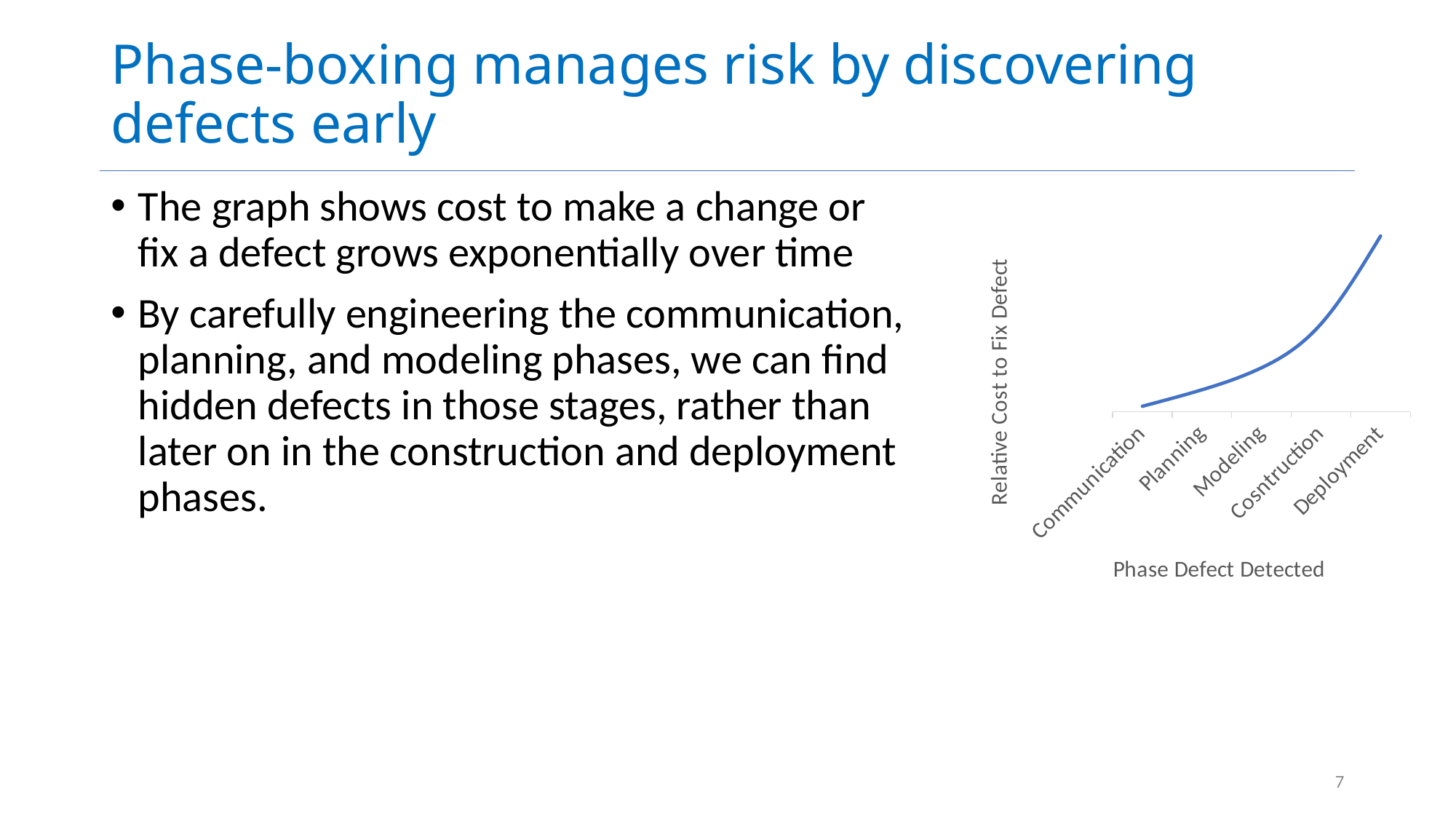
Does the relative cost to fix a defect rise or fall from Communication to Deployment? Rise Which phase has a higher relative cost to fix a defect, Planning or Construction? Construction What is the title of the x axis of the chart? Phase Defect Detected Which phase has the highest relative cost to fix a defect in the chart? Deployment What is the title of the y axis of the chart? Relative Cost to Fix Defect What kind of chart is shown on the slide? Line chart Which phase has a higher relative cost to fix a defect, Deployment or Modeling? Deployment Which phase has the lowest relative cost to fix a defect in the chart? Communication How many phases are listed along the x axis of the chart? 5 Which phase comes immediately after Modeling on the x axis of the chart? Construction